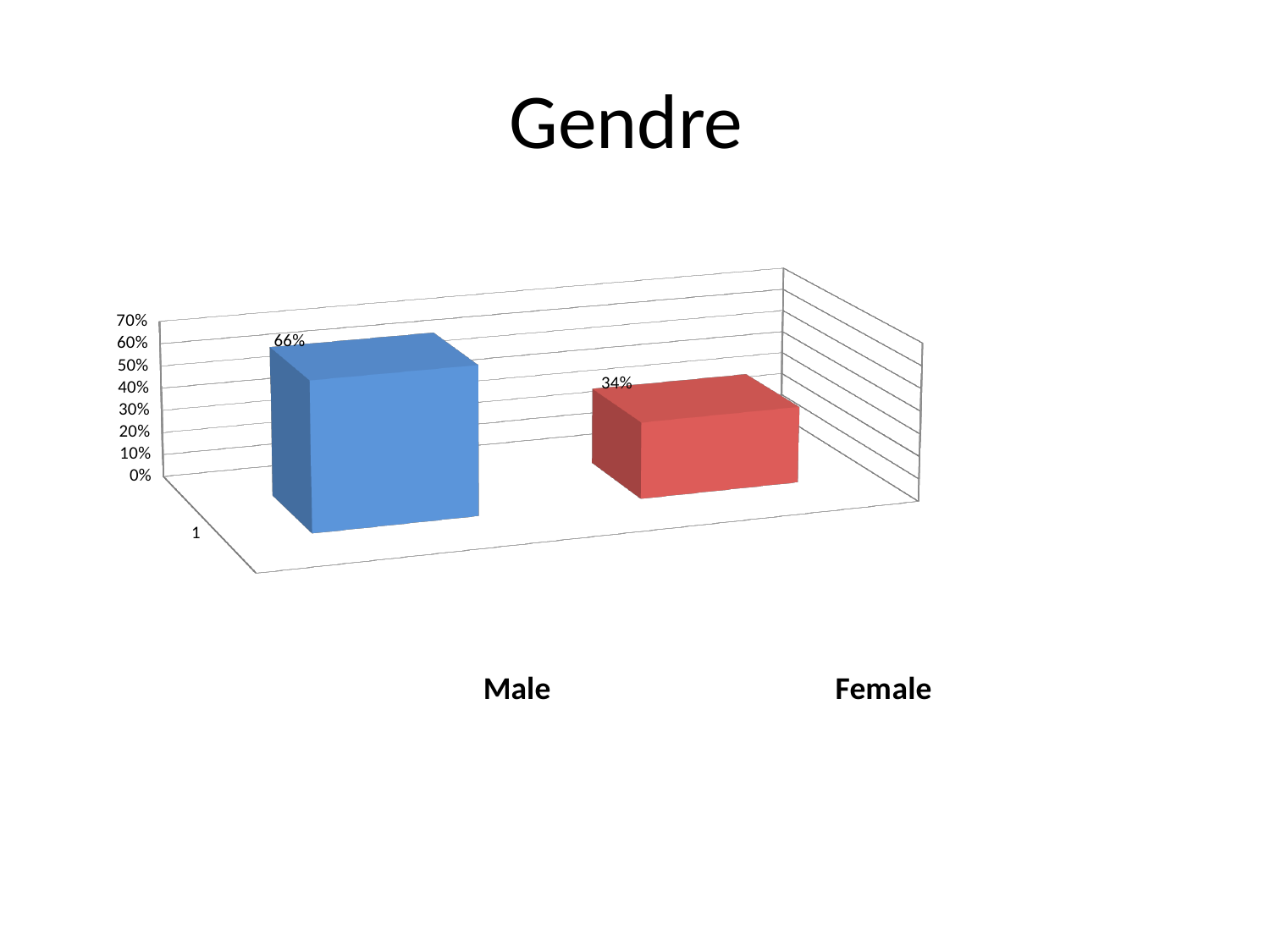
Is the value for Female greater or less than 50%? less What colour is the Male bar? blue What is the value for Female? 34% What is the difference between the Male and Female values? 32% Is the value for Male greater or less than 60%? greater Which is larger, the value for Male or the value for Female? Male What kind of chart is shown on the slide? bar chart Which category has the highest value? Male What is the value for Male? 66% What is the title of the slide? Gendre Which category has the lowest value? Female How many bars are plotted on the chart? 2